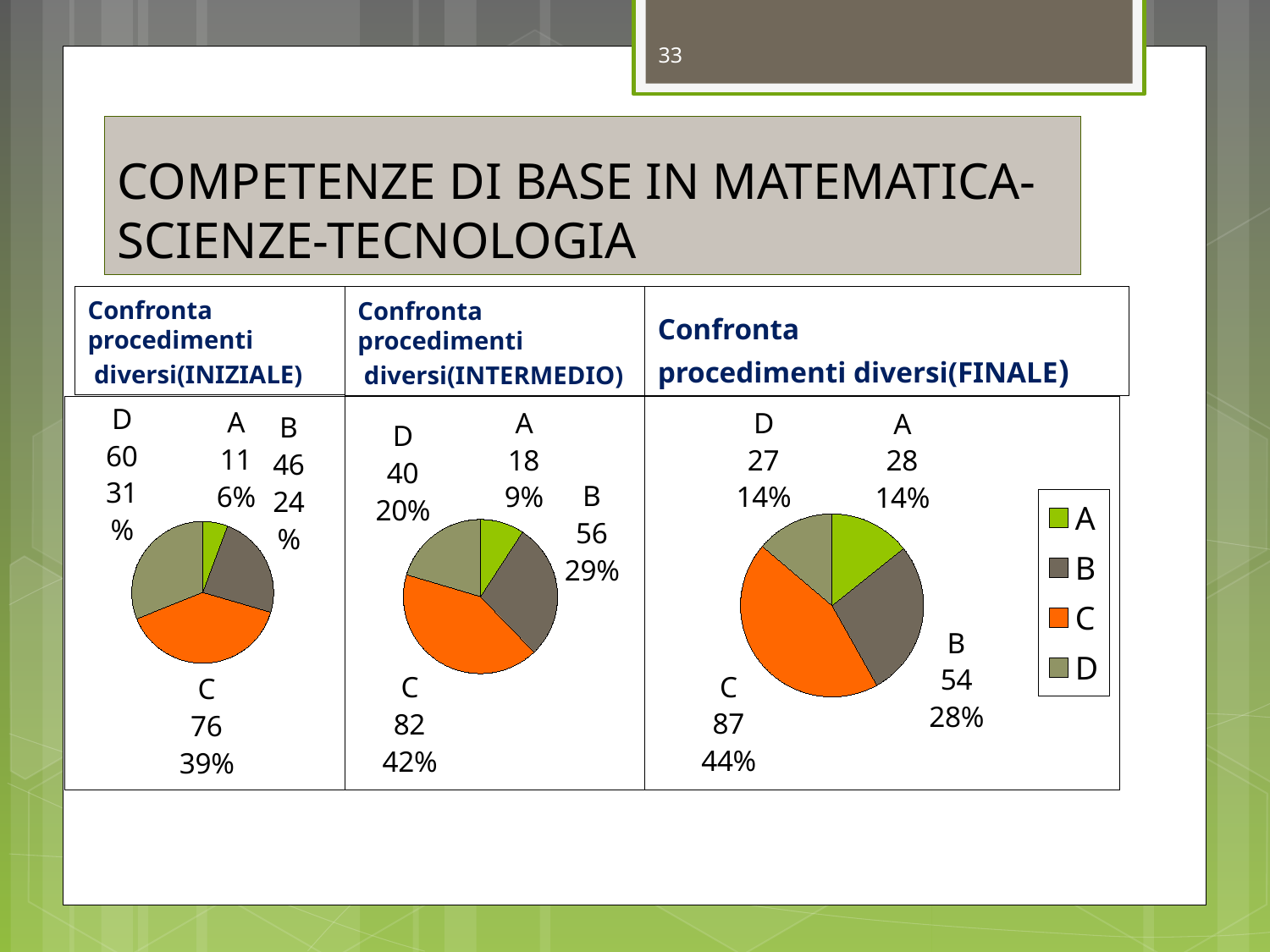
In the INIZIALE pie chart, what share of the pie does category B have? 24% In the INTERMEDIO pie chart, what is the value for category D? 40 In the FINALE pie chart, what share of the pie does category C have? 44% In the INIZIALE pie chart, which category has the smallest slice? A In the INTERMEDIO pie chart, what share of the pie does category C have? 42% In the FINALE pie chart, which is larger, the value for A or the value for B? B In the FINALE pie chart, what is the value for category B? 54 In the INIZIALE pie chart, what is the value for category C? 76 How many categories does the legend of the FINALE chart list? 4 In the INTERMEDIO pie chart, which category has the largest slice? C What kind of chart is used in the INIZIALE panel? Pie chart In the FINALE pie chart, what is the difference between the values for C and B? 33